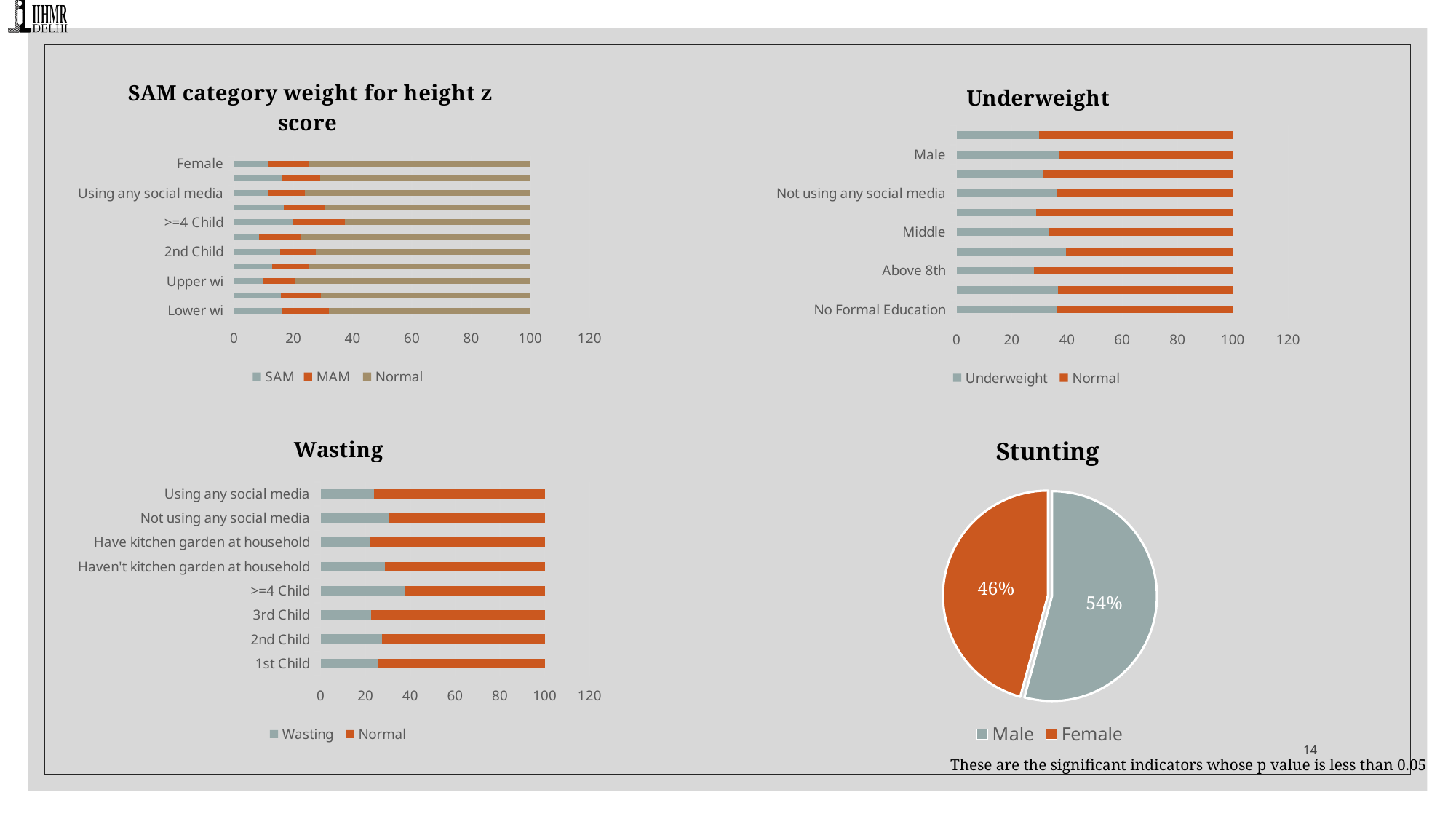
In the Stunting chart, what share of the pie is Male? 54% In the Stunting chart, what is the difference in percentage points between the Male and Female slices? 8 In the Stunting chart, what share of the pie is Female? 46% In the Wasting chart, which series is shown in orange? Normal How many series does the legend of the SAM category weight for height z score chart list? 3 In the Underweight chart, is the Underweight value for Above 8th greater or less than 40? less In the Stunting chart, which slice is larger, Male or Female? Male How many categories are shown in the Wasting chart? 8 What kind of chart is the Stunting chart? Pie chart How many series does the legend of the Underweight chart list? 2 What kind of chart is the Wasting chart? Bar chart In the Wasting chart, is the Wasting value for >=4 Child greater or less than 20? greater